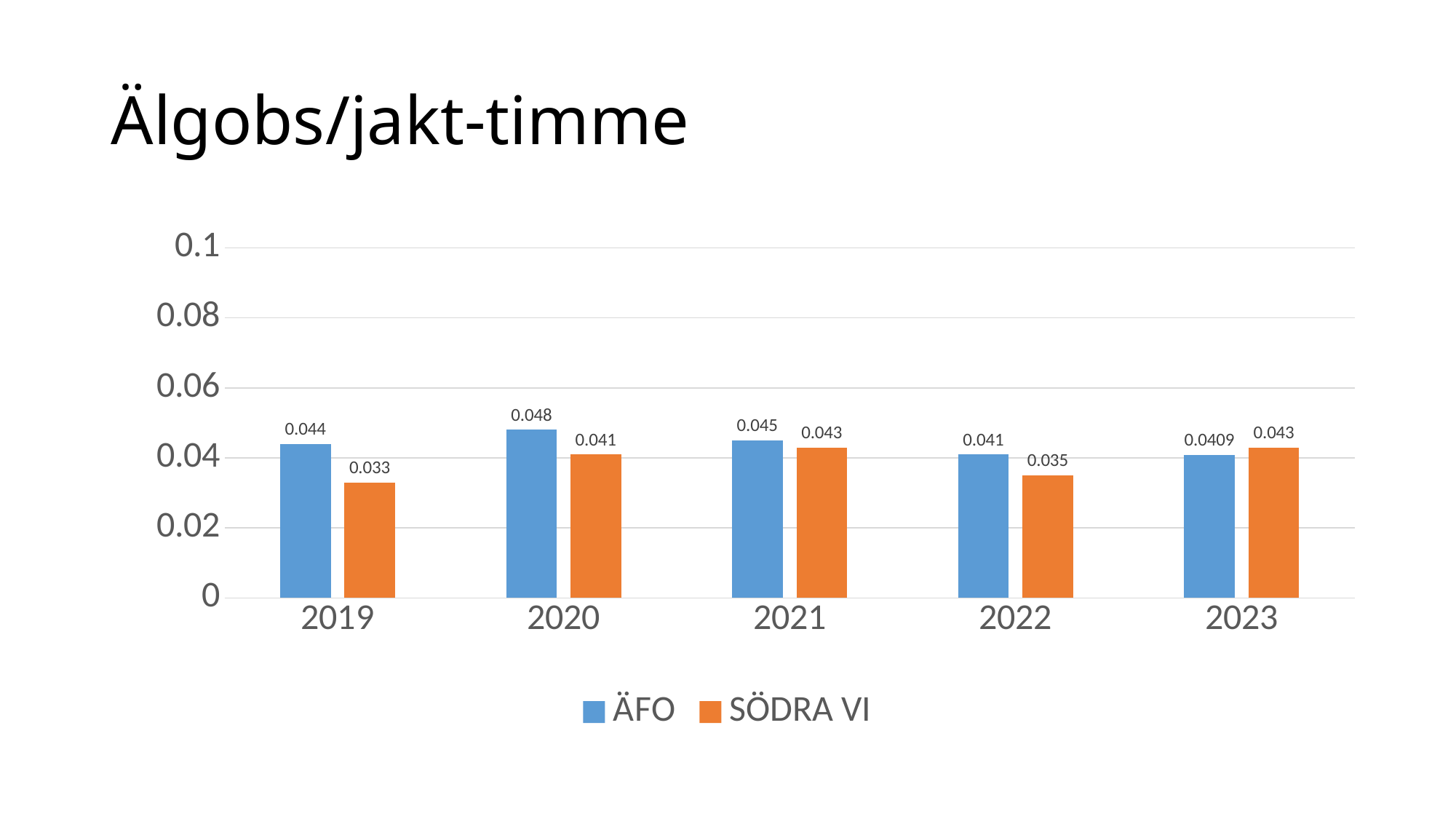
How many series does the legend list? 2 In which year is the ÄFO value highest? 2020 What is the title of the slide? Älgobs/jakt-timme Is the ÄFO value for 2021 greater or less than 0.06? less In which year is the SÖDRA VI value lowest? 2019 What is the SÖDRA VI value for 2019? 0.033 How many years are shown on the x axis? 5 What kind of chart is shown on the slide? bar chart What is the difference between the ÄFO and SÖDRA VI values in 2019? 0.011 What is the ÄFO value for 2020? 0.048 What is the ÄFO value for 2023? 0.0409 Which is larger in 2022, ÄFO or SÖDRA VI? ÄFO